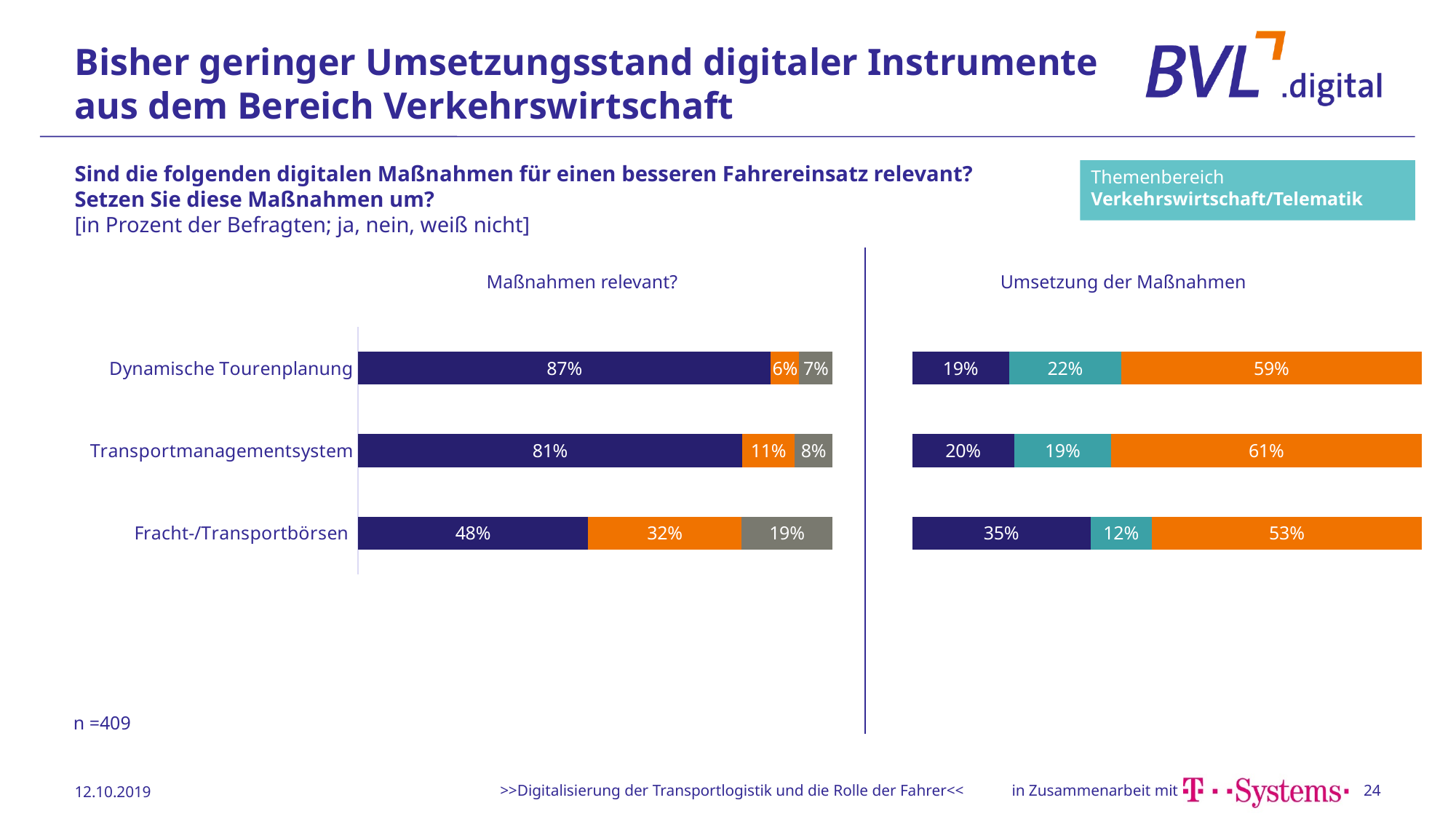
In the 'Maßnahmen relevant?' chart, what is the difference between the dark blue segment values for Dynamische Tourenplanung and Fracht-/Transportbörsen? 39 percentage points How many categories are shown in the 'Maßnahmen relevant?' chart? 3 What kind of chart is the 'Umsetzung der Maßnahmen' chart? Stacked bar chart In the 'Umsetzung der Maßnahmen' chart, which category has the lowest value in the first (dark blue) segment? Dynamische Tourenplanung In the 'Umsetzung der Maßnahmen' chart, what is the value of the teal segment for Fracht-/Transportbörsen? 12% In the 'Maßnahmen relevant?' chart, what is the total of the three segments for Transportmanagementsystem? 100% In the 'Umsetzung der Maßnahmen' chart, what is the value of the orange segment for Transportmanagementsystem? 61% In the 'Umsetzung der Maßnahmen' chart, which is larger: the orange segment for Dynamische Tourenplanung or for Fracht-/Transportbörsen? Dynamische Tourenplanung In the 'Maßnahmen relevant?' chart, which category has the highest value in the first (dark blue) segment? Dynamische Tourenplanung What sample size (n) is stated on the slide? n =409 In the 'Maßnahmen relevant?' chart, what is the value of the grey segment for Fracht-/Transportbörsen? 19% In the 'Maßnahmen relevant?' chart, what is the value of the first (dark blue) segment for Dynamische Tourenplanung? 87%